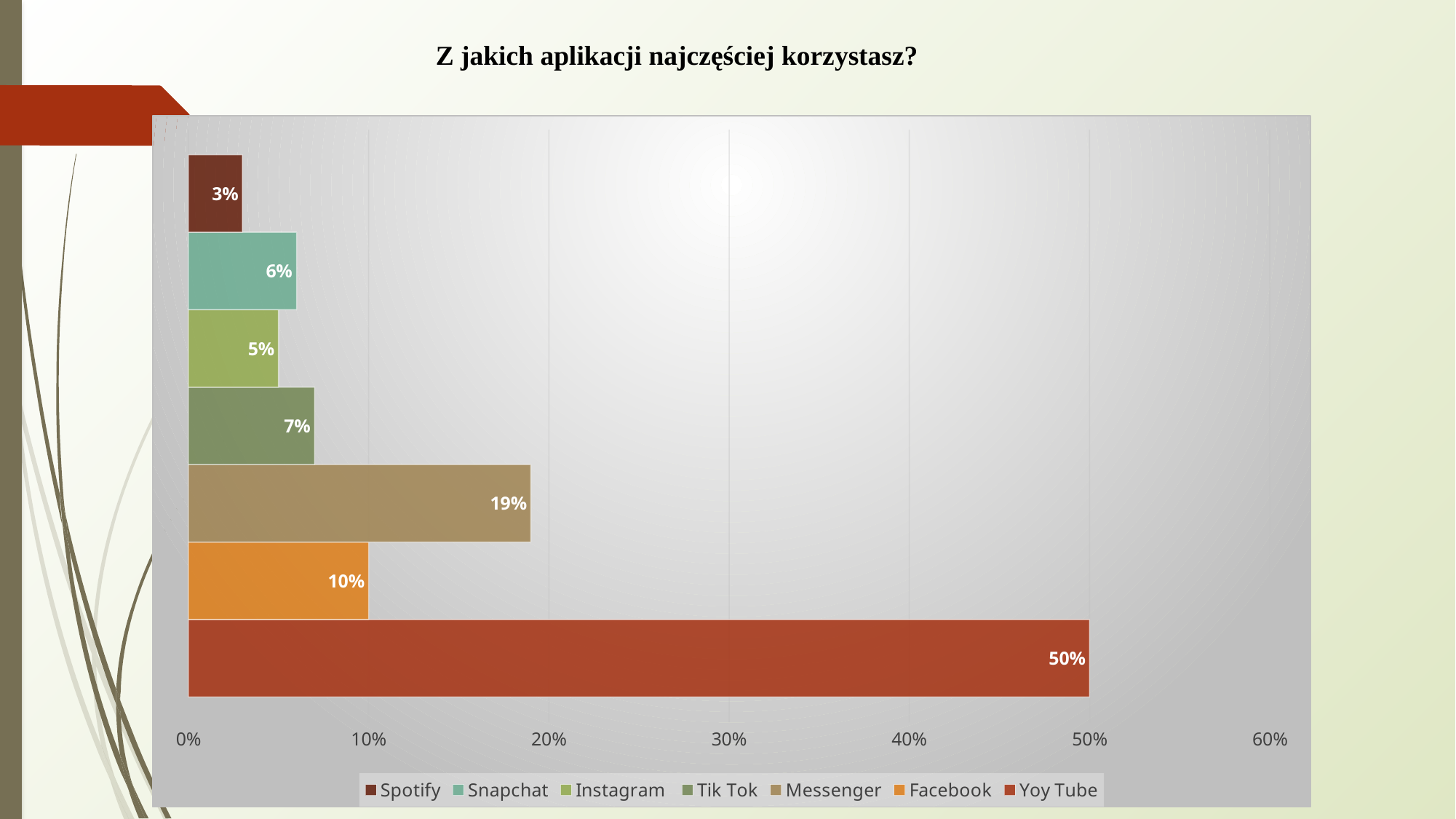
What is the value for Spotify? 3% Which application has the lowest value? Spotify Which application has the highest value? Yoy Tube What kind of chart is shown on the slide? bar chart Which has a larger value, Facebook or Snapchat? Facebook Is the value for Messenger greater or less than 20%? less What is the value for Tik Tok? 7% What is the title of the chart? Z jakich aplikacji najczęściej korzystasz? What is the value for Yoy Tube? 50% How many bars are plotted in the chart? 7 What is the difference between the values for Yoy Tube and Messenger? 31% What is the value for Messenger? 19%